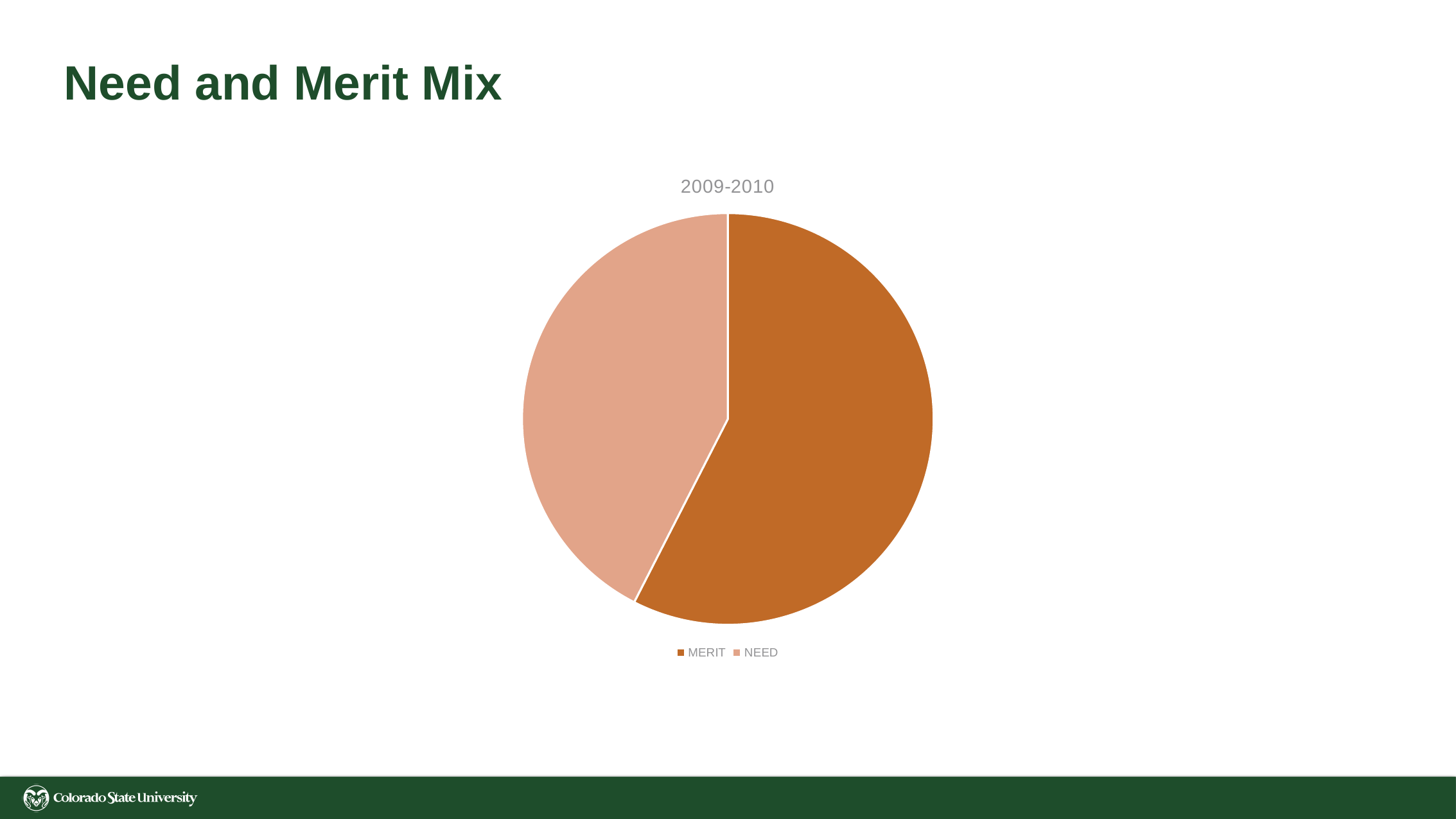
Which slice is larger in the pie chart, MERIT or NEED? MERIT Which category has the largest slice in the pie chart? MERIT What kind of chart is shown on the slide? pie chart How many slices does the pie chart have? 2 Which category has the smallest slice in the pie chart? NEED What is the title of the pie chart? 2009-2010 Which category is shown in the darker orange colour in the pie chart? MERIT Does the MERIT slice take up more or less than half of the pie chart? more How many entries does the legend of the pie chart list? 2